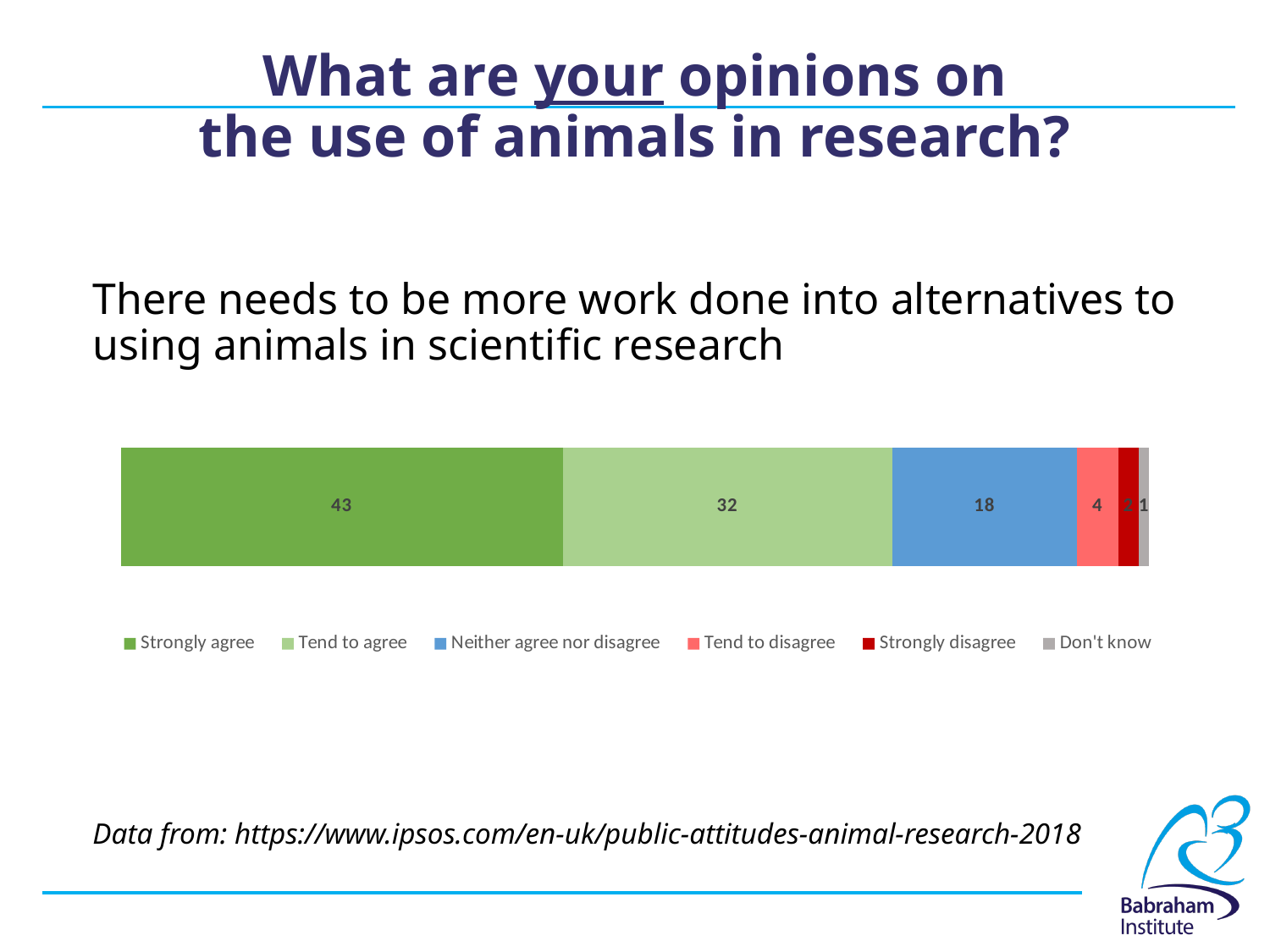
Which response category has the lowest value? Don't know What value is shown for "Neither agree nor disagree"? 18 What value is shown for "Strongly agree"? 43 Which response category has the highest value? Strongly agree What is the difference between the values for "Strongly agree" and "Tend to agree"? 11 What kind of chart is shown on the slide? Stacked bar chart What value is shown for "Tend to agree"? 32 What is the total of all the segments in the stacked bar? 100 What value is shown for "Tend to disagree"? 4 What colour is the "Neither agree nor disagree" segment? Blue How many series does the legend list? 6 Which is larger, the value for "Neither agree nor disagree" or the value for "Tend to disagree"? Neither agree nor disagree